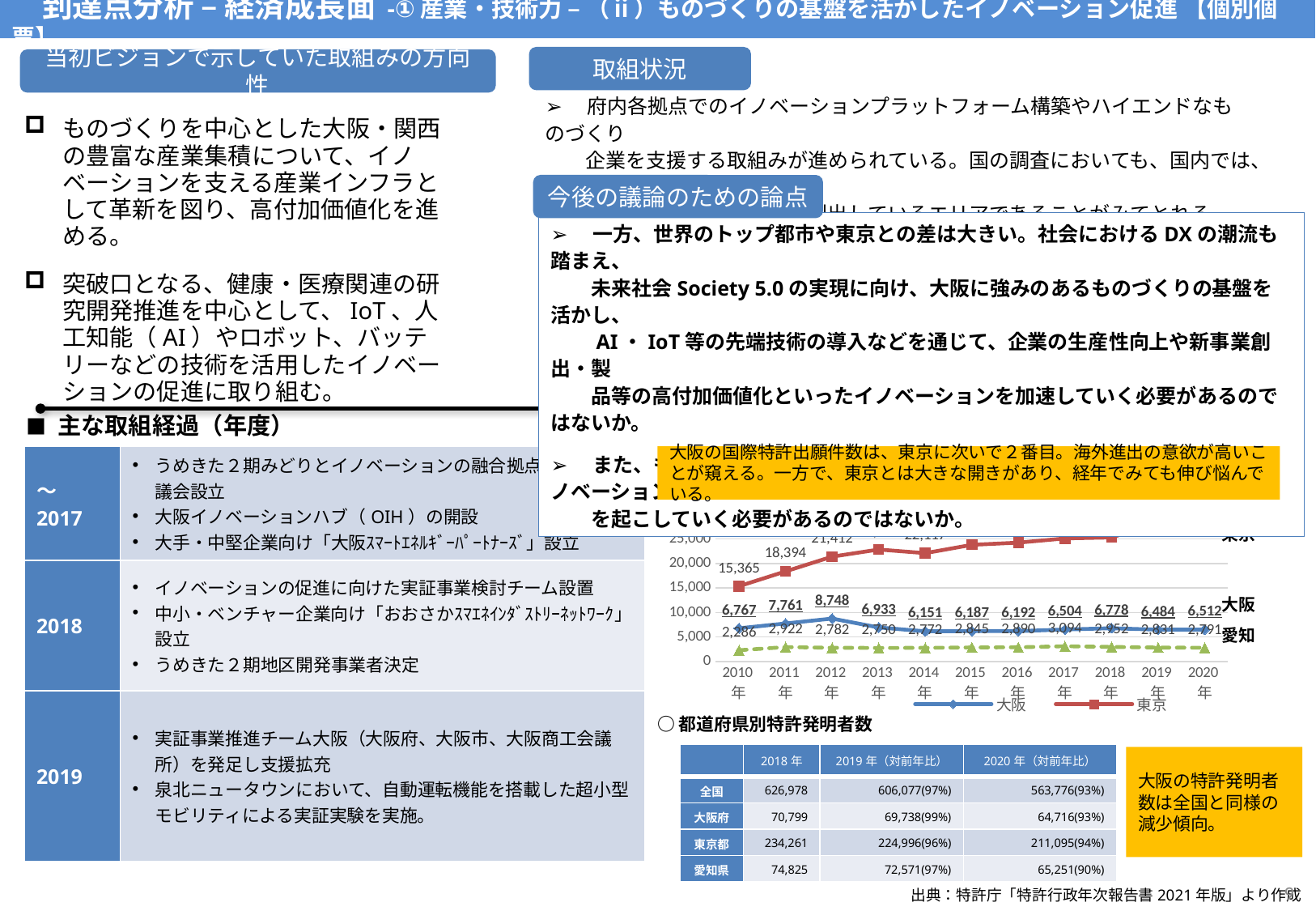
In the line chart, is the value for 愛知 in 2010年 greater or less than 5,000? less In the line chart, what is the value for 愛知 in 2017年? 3,094 In the line chart, in which year is the value for 大阪 highest? 2012年 In the line chart, what is the value for 東京 in 2010年? 15,365 In the line chart, what is the value for 大阪 in 2010年? 6,767 In the line chart, what is the value for 東京 in 2011年? 18,394 In the line chart, what is the value for 大阪 in 2012年? 8,748 In the line chart, in which year is the value for 愛知 lowest? 2010年 In the line chart, which year has the larger value for 大阪, 2018年 or 2019年? 2018年 What kind of chart is shown on the right side of the slide with the years 2010 to 2020 on the x axis? line chart In the line chart, what is the difference between the 大阪 values for 2012年 and 2011年? 987 How many years are plotted on the x axis of the line chart? 11